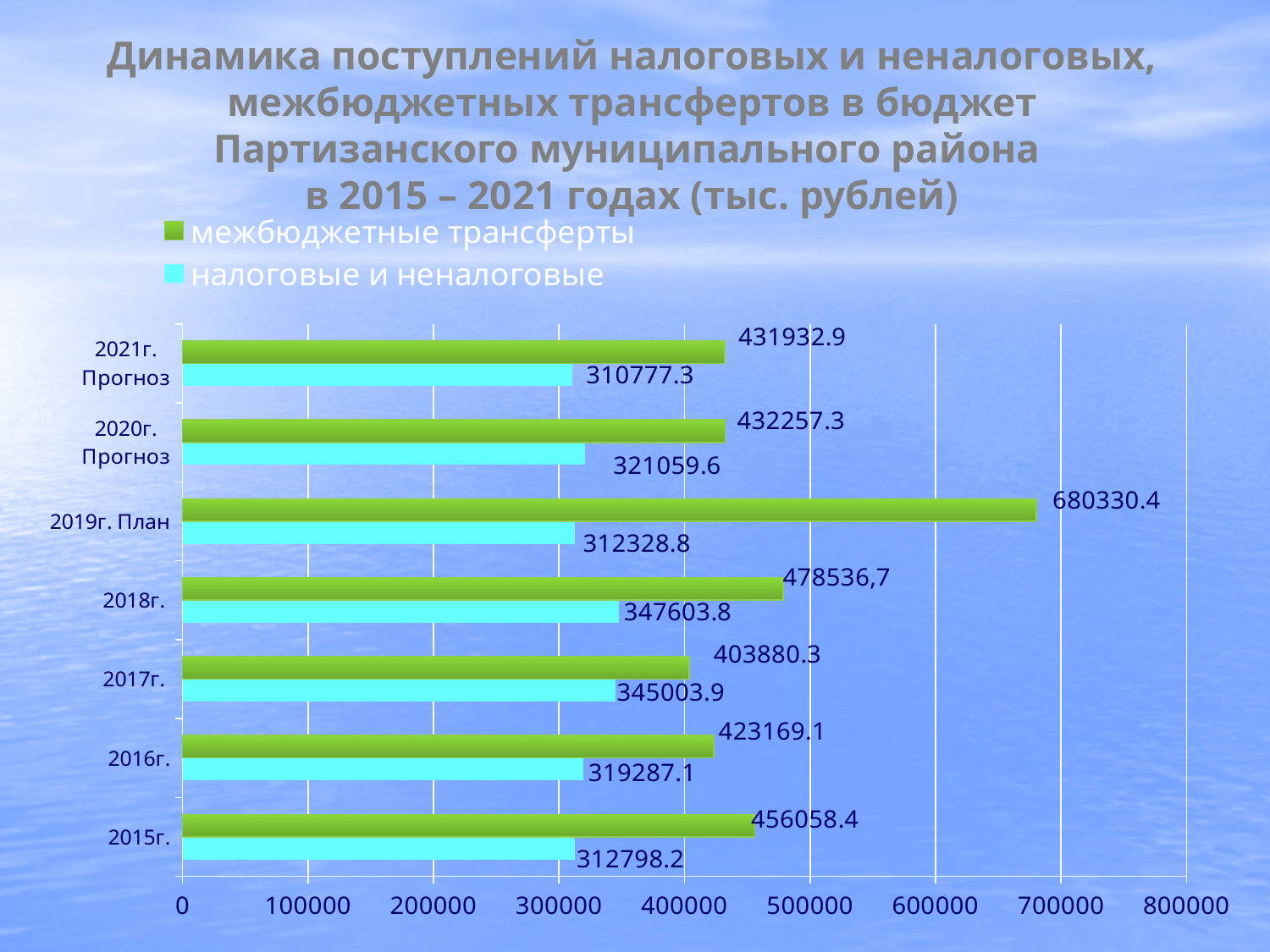
Which category has the highest value for налоговые и неналоговые? 2018г. How many series does the legend list? 2 Which category has the highest value for межбюджетные трансферты? 2019г. План Which category has the lowest value for межбюджетные трансферты? 2017г. What is the value of налоговые и неналоговые for 2021г. Прогноз? 310777.3 What is the value of межбюджетные трансферты for 2016г.? 423169.1 What is the difference between межбюджетные трансферты and налоговые и неналоговые for 2019г. План? 368001.6 What is the value of налоговые и неналоговые for 2018г.? 347603.8 What is the value of межбюджетные трансферты for 2019г. План? 680330.4 Which is larger: межбюджетные трансферты for 2015г. or for 2016г.? 2015г. How many categories are shown on the chart? 7 Is the value of налоговые и неналоговые for 2019г. План greater or less than 400000? less